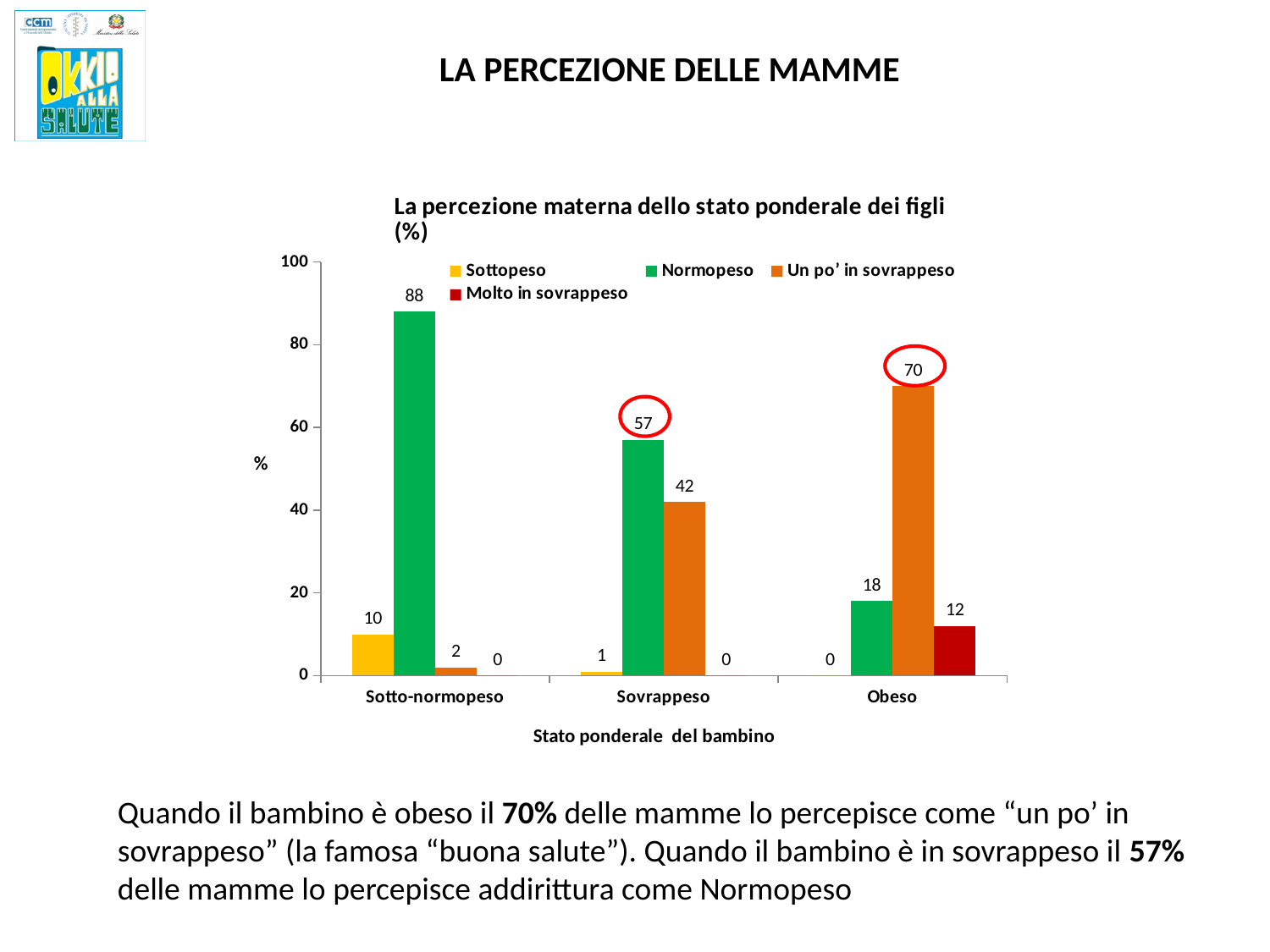
What is the value for Normopeso in the Sovrappeso category? 57 How many series does the legend list? 4 How many categories are shown on the x axis? 3 What is the value for Molto in sovrappeso in the Obeso category? 12 Which series has the highest value in the Obeso category? Un po' in sovrappeso What is the value for Un po' in sovrappeso in the Obeso category? 70 What is the title of the chart? La percezione materna dello stato ponderale dei figli (%) What is the value for Normopeso in the Sotto-normopeso category? 88 Which series has the lowest value in the Sotto-normopeso category? Molto in sovrappeso What is the difference between the Normopeso and Un po' in sovrappeso values in the Sovrappeso category? 15 What kind of chart is shown on the slide? Bar chart Which is larger: the Sottopeso value for Sotto-normopeso or the Normopeso value for Obeso? Normopeso value for Obeso